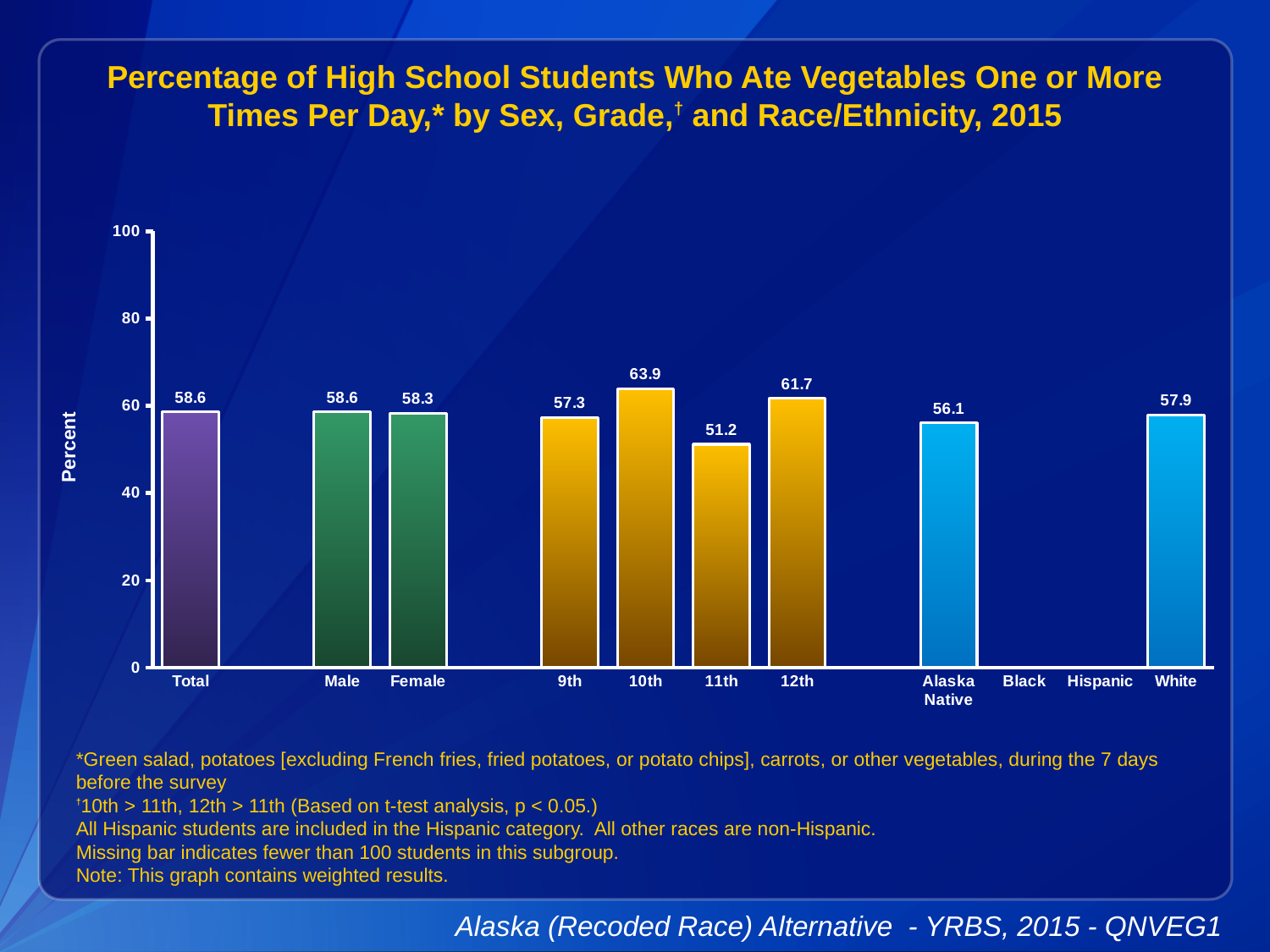
How many bars are plotted on the chart? 9 Which category has the highest value? 10th Is the value for 11th grade greater or less than 60? less What kind of chart is shown? bar chart Which is larger, the value for 12th grade or the value for 9th grade? 12th What is the difference between the values for Male and Female? 0.3 What is the label of the y axis? Percent What is the difference between the values for 10th and 11th grade? 12.7 What is the value for 10th grade? 63.9 What is the value for Alaska Native? 56.1 What is the value for Total? 58.6 Which category has the lowest value among the bars shown? 11th